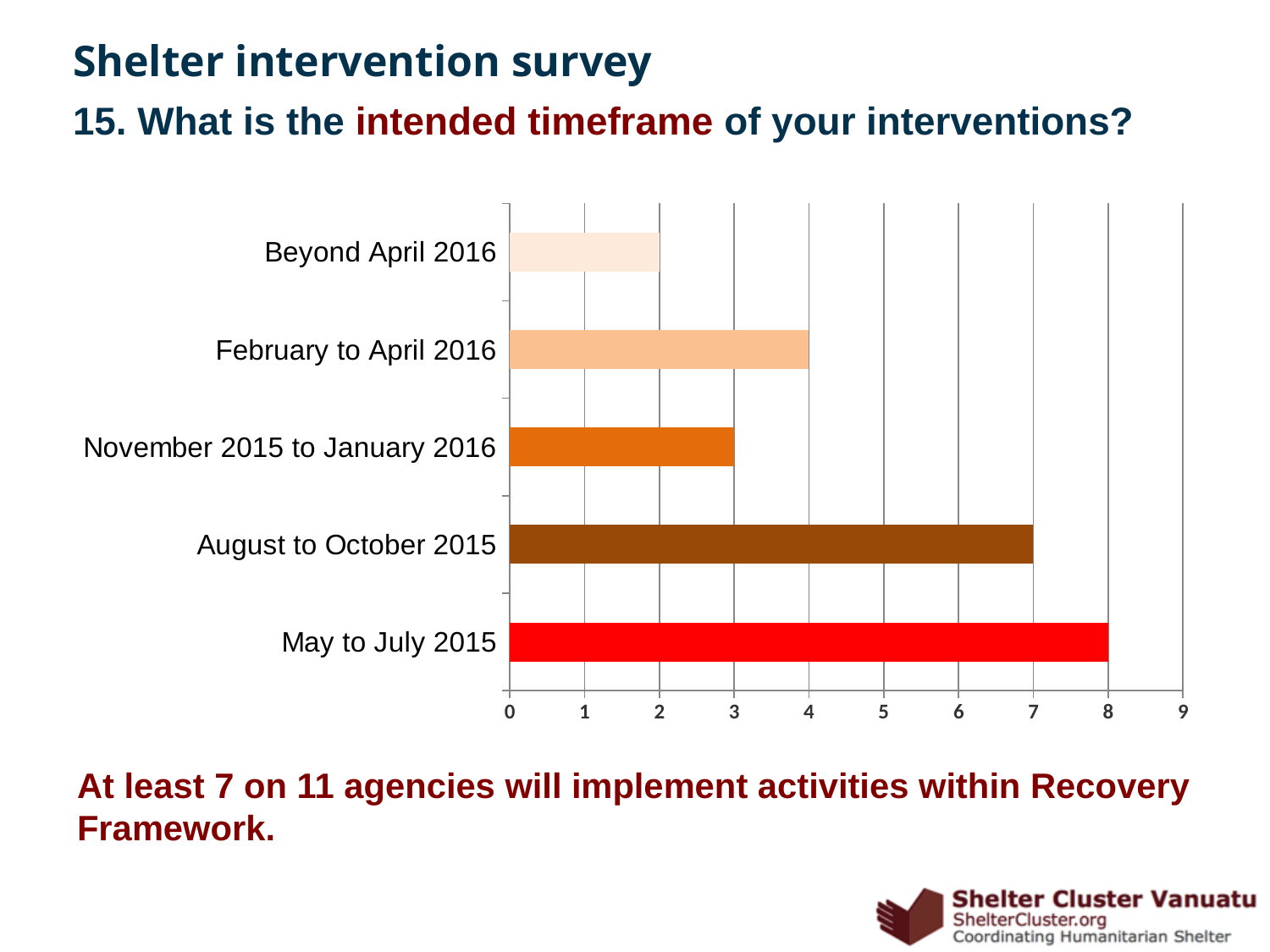
What is the value for Beyond April 2016? 2 What is the value for May to July 2015? 8 How many categories (timeframes) are plotted in the chart? 5 What is the value for November 2015 to January 2016? 3 What kind of chart is shown on the slide? bar chart Which is larger, the value for February to April 2016 or the value for Beyond April 2016? February to April 2016 What is the value for February to April 2016? 4 What is the difference between the values for May to July 2015 and November 2015 to January 2016? 5 Which timeframe has the highest value? May to July 2015 What is the value for August to October 2015? 7 What is the highest value shown on the horizontal axis of the chart? 9 Which timeframe has the lowest value? Beyond April 2016